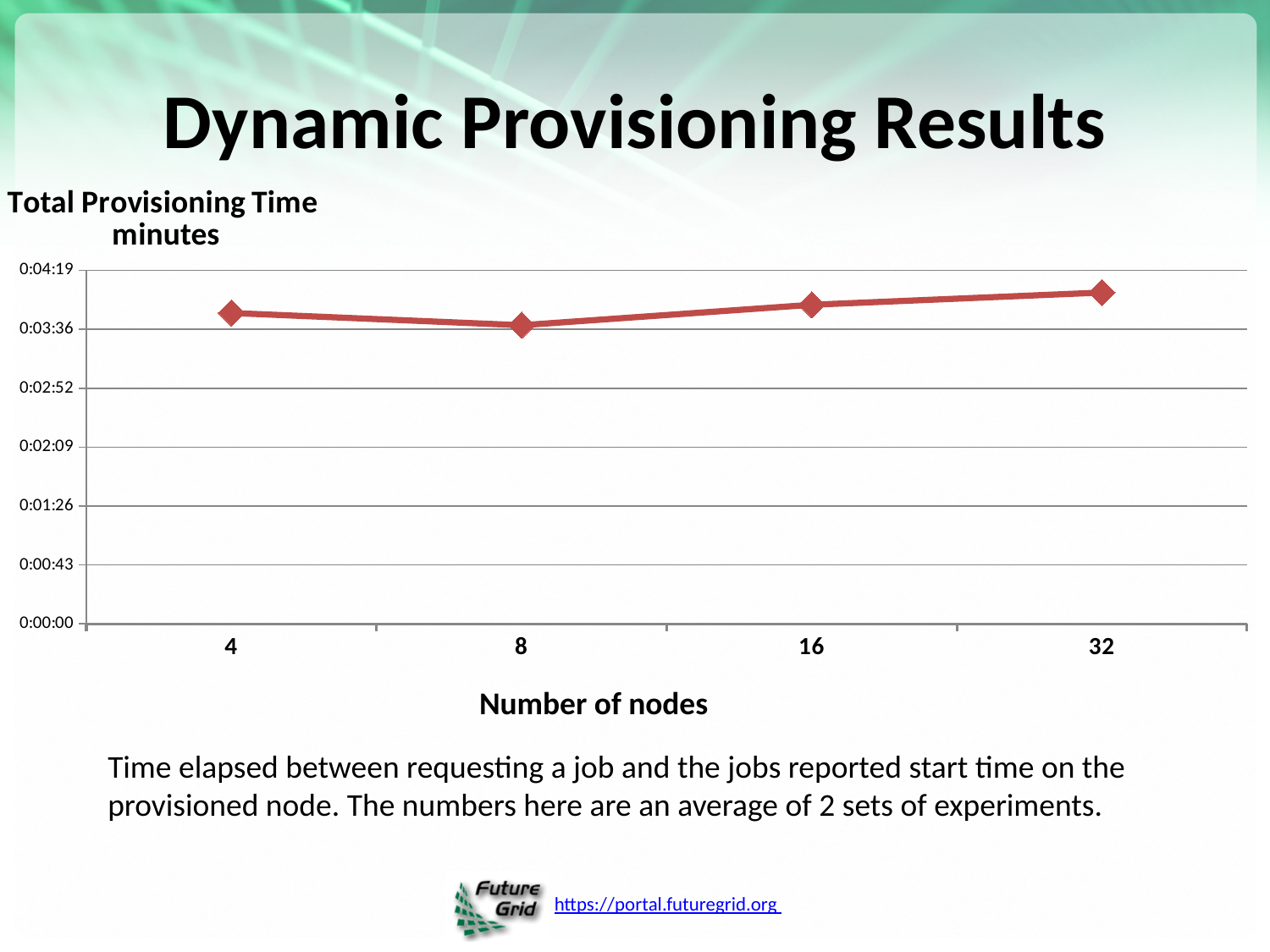
Which number of nodes has the highest total provisioning time? 32 Which number of nodes has the lowest total provisioning time? 8 Is the total provisioning time for 16 nodes greater or less than 0:02:52? greater What is the title of the chart? Total Provisioning Time minutes From 8 nodes to 32 nodes, does the total provisioning time rise or fall? rise How many data points are plotted on the line? 4 Which has a larger total provisioning time, 4 nodes or 8 nodes? 4 nodes What is the label of the x axis? Number of nodes What kind of chart is shown on the slide? line chart Is the total provisioning time for 4 nodes greater or less than 0:03:36? greater Is the total provisioning time for 32 nodes greater or less than 0:04:19? less Which has a larger total provisioning time, 8 nodes or 32 nodes? 32 nodes